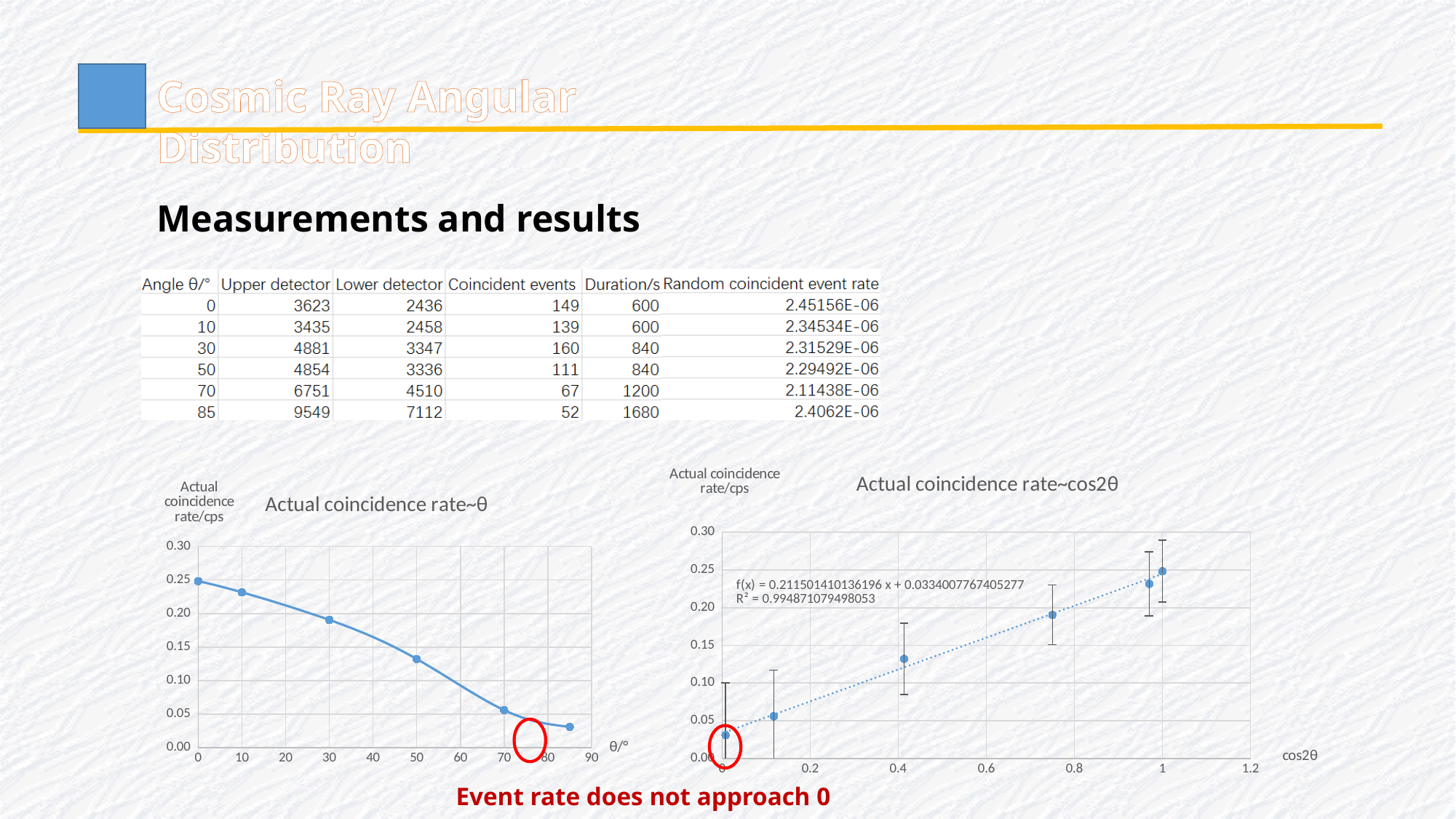
In the left chart 'Actual coincidence rate~θ', at which θ value is the actual coincidence rate highest? 0 In the left chart 'Actual coincidence rate~θ', which has the larger actual coincidence rate, θ = 10 or θ = 50? θ = 10 What kind of chart is the right chart titled 'Actual coincidence rate~cos2θ'? scatter chart In the left chart 'Actual coincidence rate~θ', how many data points are plotted? 6 In the left chart 'Actual coincidence rate~θ', do the values rise or fall as θ increases? fall In the right chart 'Actual coincidence rate~cos2θ', what R² value is printed for the fitted line? 0.994871079498053 In the left chart 'Actual coincidence rate~θ', is the value at θ = 70 greater or less than 0.10? less In the right chart 'Actual coincidence rate~cos2θ', is the value at cos2θ = 1 greater or less than 0.20? greater What kind of chart is the left chart titled 'Actual coincidence rate~θ'? line chart In the left chart 'Actual coincidence rate~θ', is the value at θ = 0 greater or less than 0.20? greater In the left chart 'Actual coincidence rate~θ', at which θ value is the actual coincidence rate lowest? 85 In the right chart 'Actual coincidence rate~cos2θ', do the values rise or fall as cos2θ increases? rise